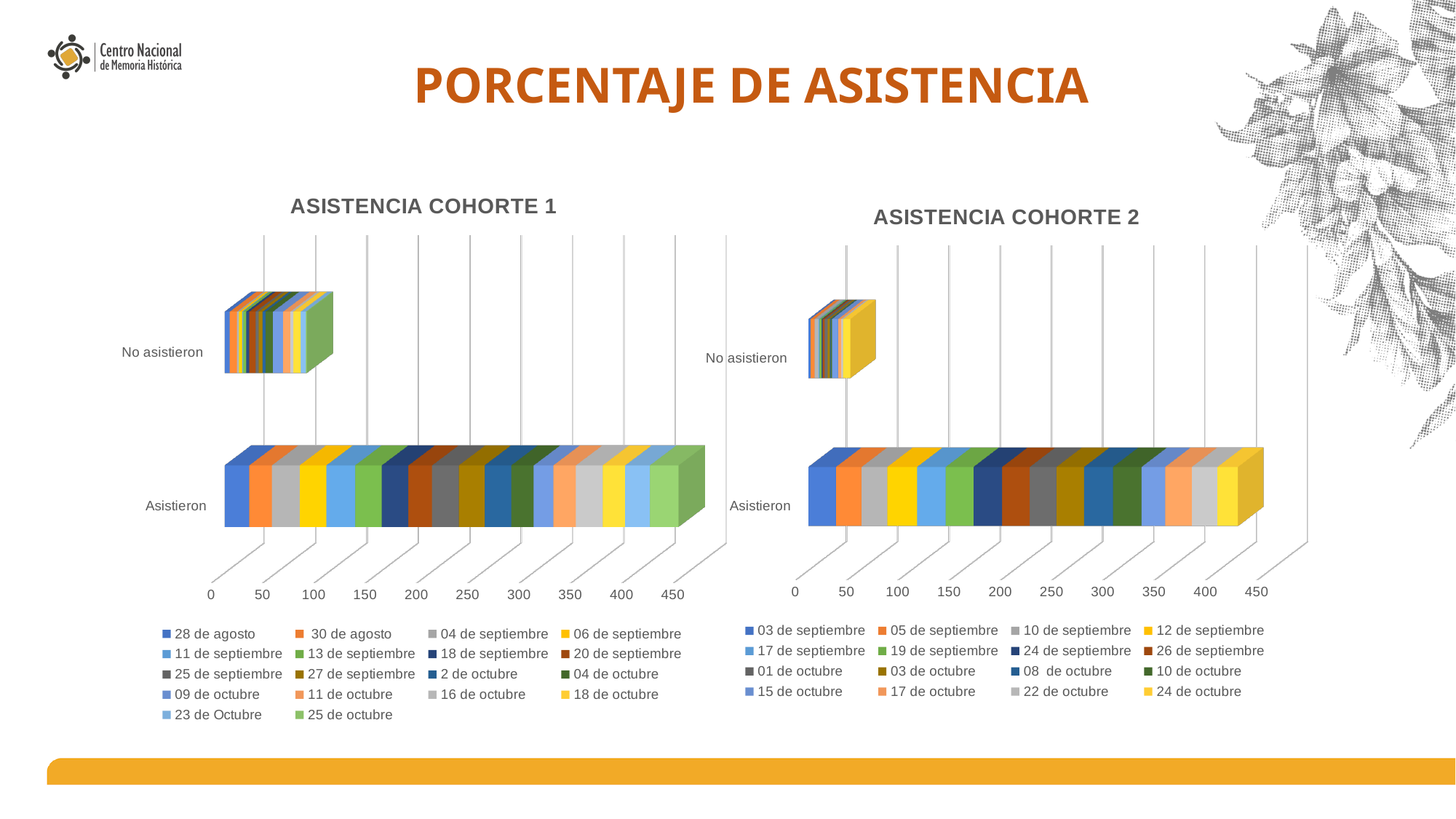
What kind of chart is ASISTENCIA COHORTE 1? Stacked bar chart In the ASISTENCIA COHORTE 1 chart, which category has the longer bar, Asistieron or No asistieron? Asistieron What is the first legend entry of the ASISTENCIA COHORTE 2 chart? 03 de septiembre In the ASISTENCIA COHORTE 2 chart, is the total for Asistieron greater or less than 400? greater In the ASISTENCIA COHORTE 1 chart, is the total for Asistieron greater or less than 300? greater In the ASISTENCIA COHORTE 2 chart, which category has the lowest total? No asistieron In the ASISTENCIA COHORTE 1 chart, is the total for No asistieron greater or less than 150? less How many series does the legend of the ASISTENCIA COHORTE 1 chart list? 18 How many series does the legend of the ASISTENCIA COHORTE 2 chart list? 16 In the ASISTENCIA COHORTE 2 chart, which category has the highest total? Asistieron In the ASISTENCIA COHORTE 1 chart, how many categories are shown on the vertical axis? 2